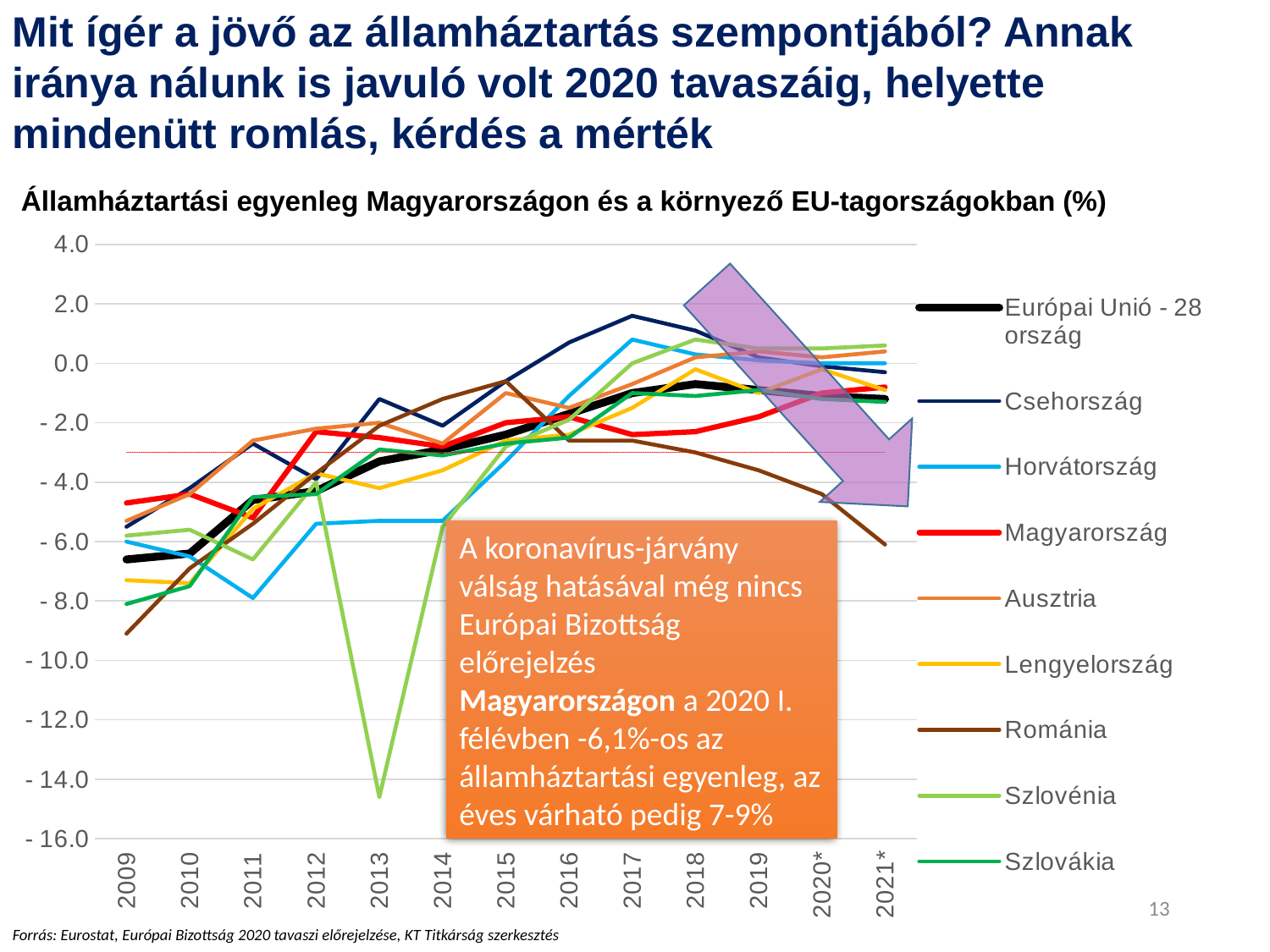
Is the value for Csehország in 2017 greater or less than 0.0? greater Which series has the lowest value in 2009? Románia Which series is drawn with the thick black line? Európai Unió - 28 ország Is the value for Románia in 2009 greater or less than -8.0? less How many series does the legend list? 9 What is the title of the chart? Államháztartási egyenleg Magyarországon és a környező EU-tagországokban (%) Is the value for Szlovénia in 2013 greater or less than -12.0? less Which series has the lowest value in 2013? Szlovénia How many years are shown along the x axis? 13 Which is larger in 2021*, the value for Magyarország or the value for Románia? Magyarország Which series has the highest value in 2017? Csehország What kind of chart is shown on the slide? line chart